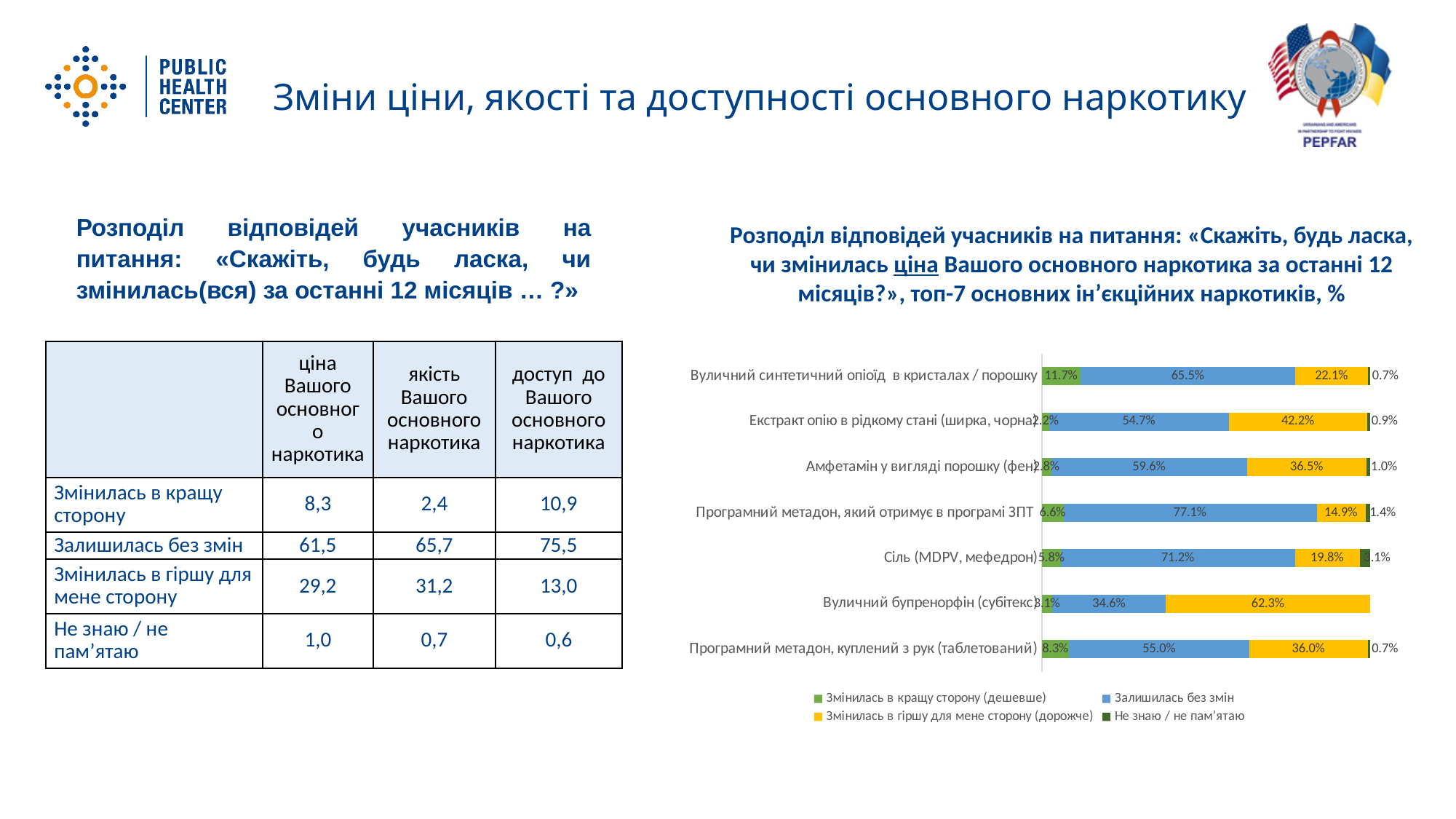
Which drug category has the highest value for "Змінилась в кращу сторону (дешевше)" in the chart? Вуличний синтетичний опіоїд в кристалах / порошку How many drug categories are shown in the chart? 7 In the chart, what is the value of "Не знаю / не пам’ятаю" for "Програмний метадон, який отримує в програмі ЗПТ"? 1.4% In the chart, what is the value of "Залишилась без змін" for "Програмний метадон, який отримує в програмі ЗПТ"? 77.1% In the chart, what is the difference between "Залишилась без змін" and "Змінилась в гіршу для мене сторону (дорожче)" for "Вуличний синтетичний опіоїд в кристалах / порошку"? 43.4 percentage points Which drug category has the highest value for "Залишилась без змін" in the chart? Програмний метадон, який отримує в програмі ЗПТ What colour represents "Залишилась без змін" in the chart legend? Blue How many series does the legend of the chart list? 4 What kind of chart is shown on the right side of the slide? Stacked bar chart In the chart, which has the larger "Змінилась в гіршу для мене сторону (дорожче)" value: "Екстракт опію в рідкому стані (ширка, чорна)" or "Амфетамін у вигляді порошку (фен)"? Екстракт опію в рідкому стані (ширка, чорна) In the chart, what is the value of "Змінилась в гіршу для мене сторону (дорожче)" for "Вуличний бупренорфін (субітекс)"? 62.3% Which drug category has the lowest value for "Залишилась без змін" in the chart? Вуличний бупренорфін (субітекс)